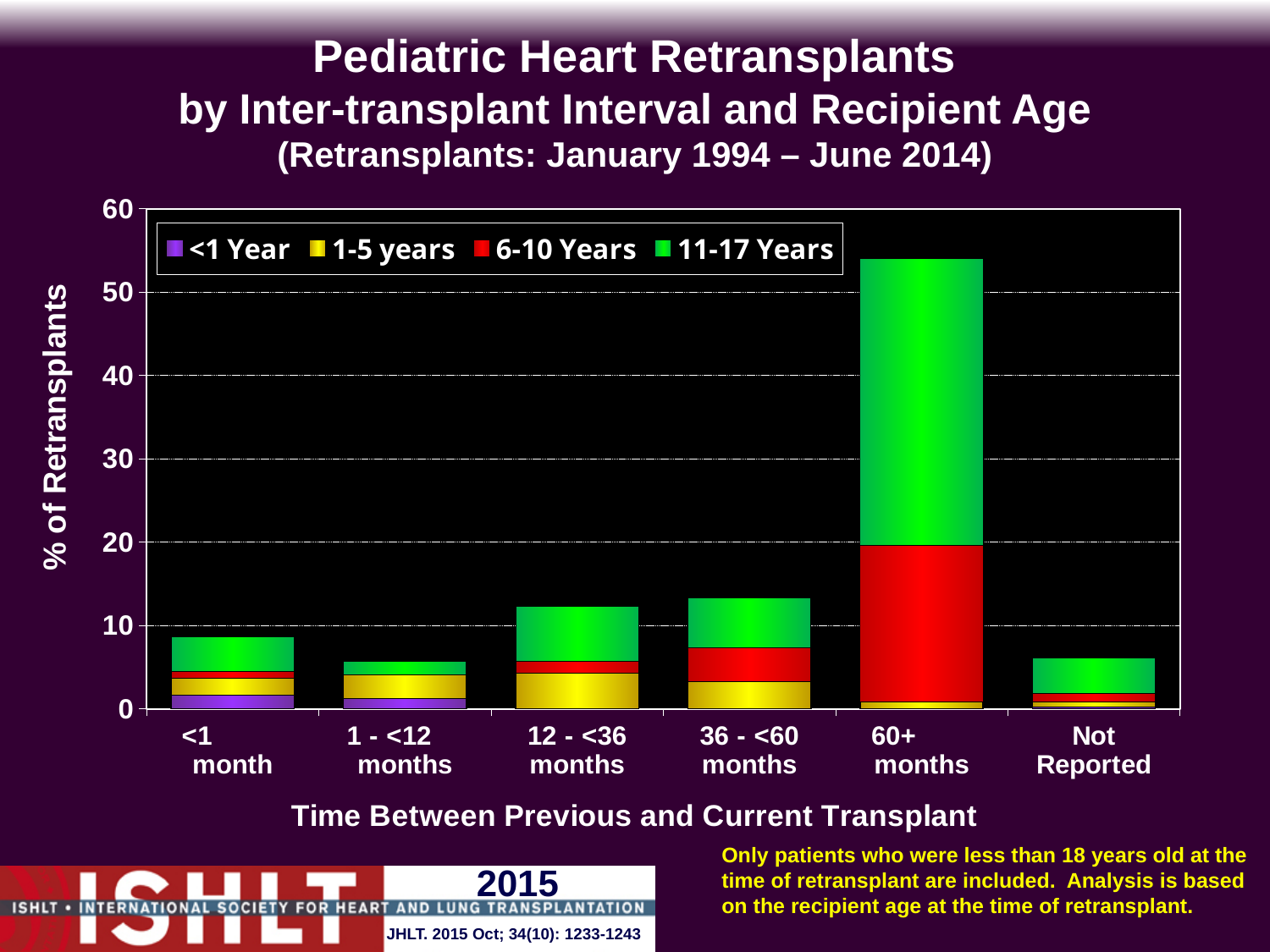
Which inter-transplant interval has the highest total percentage of retransplants? 60+ months Is the total value for the 12 - <36 months bar greater or less than 10? greater How many recipient age groups does the legend list? 4 Is the 11-17 Years segment of the 60+ months bar greater or less than 30? greater How many inter-transplant interval categories are shown on the x axis? 6 Is the total value for the 60+ months bar greater or less than 50? greater What is the title of the x axis? Time Between Previous and Current Transplant Which has a larger total percentage of retransplants, 12 - <36 months or 1 - <12 months? 12 - <36 months Which has a larger total percentage of retransplants, 60+ months or <1 month? 60+ months What kind of chart is shown on the slide? Stacked bar chart Which recipient age group is shown in green in the legend? 11-17 Years